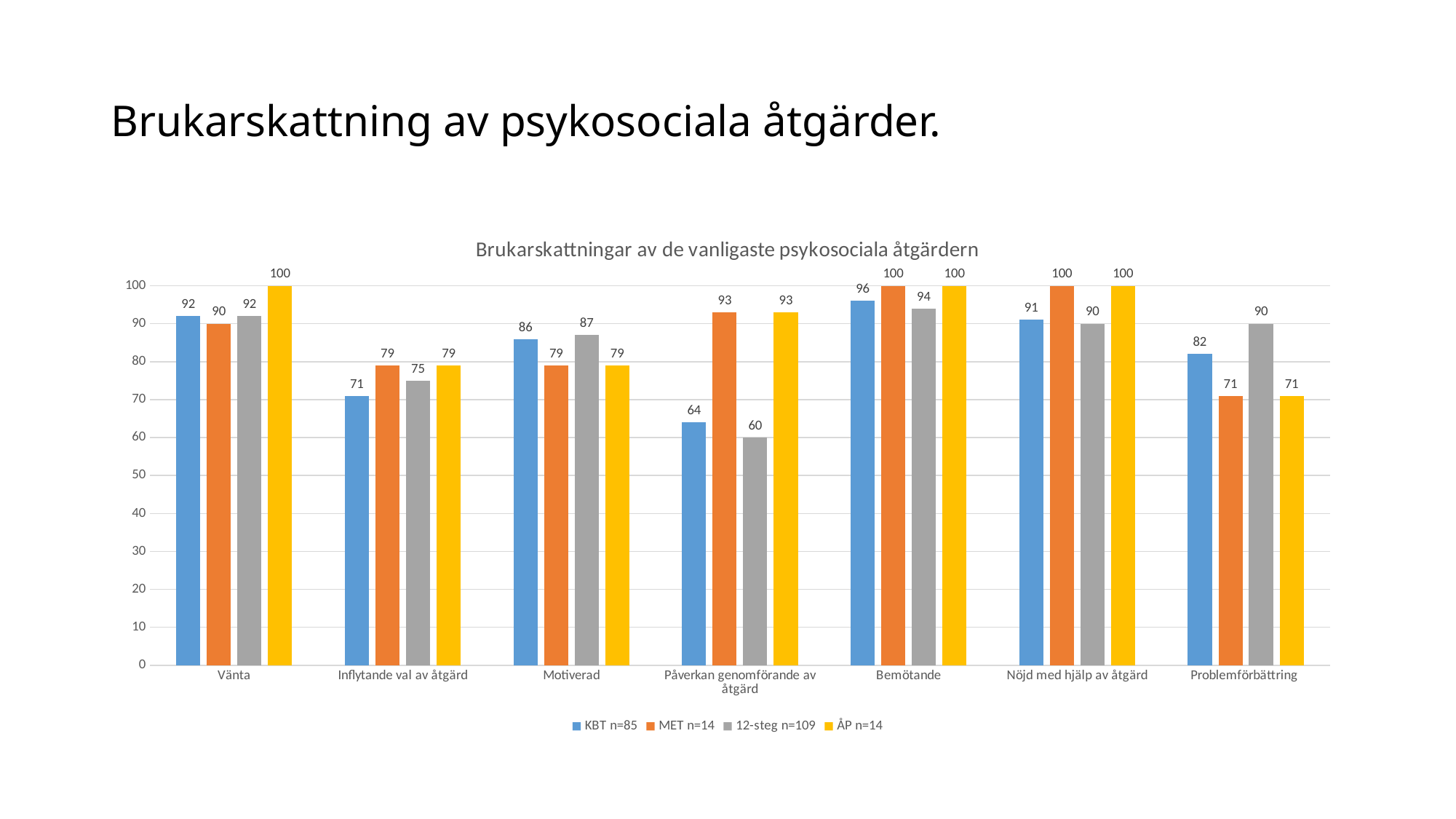
How many series does the legend list? 4 Which series has the lowest value in the Inflytande val av åtgärd category? KBT n=85 What kind of chart is shown on the slide? Bar chart What is the value for KBT n=85 in the Vänta category? 92 What is the value for 12-steg n=109 in the Påverkan genomförande av åtgärd category? 60 What is the title of the chart? Brukarskattningar av de vanligaste psykosociala åtgärdern Which series has the highest value in the Problemförbättring category? 12-steg n=109 What is the value for ÅP n=14 in the Motiverad category? 79 Which is larger in the Motiverad category: KBT n=85 or 12-steg n=109? 12-steg n=109 What is the difference between the MET n=14 and KBT n=85 values in the Påverkan genomförande av åtgärd category? 29 Is the value for KBT n=85 in the Bemötande category greater or less than 90? greater How many categories are shown on the x axis? 7